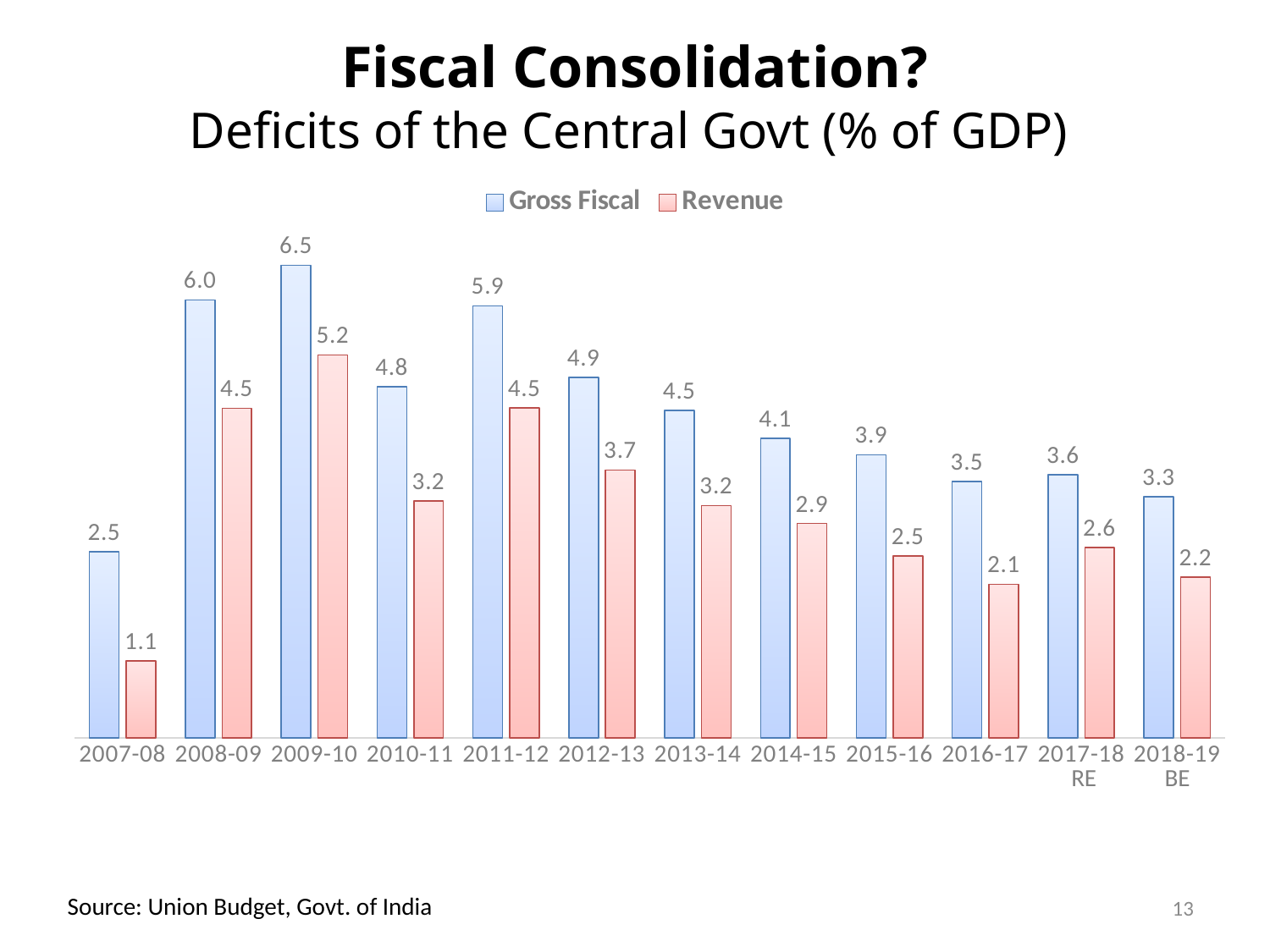
How many series does the legend list? 2 What is the Revenue deficit for 2018-19 BE? 2.2 Which is larger, the Revenue deficit in 2011-12 or in 2012-13? 2011-12 How many years are shown on the x axis? 12 What is the Gross Fiscal deficit for 2009-10? 6.5 What is the Revenue deficit for 2007-08? 1.1 What is the difference between the Gross Fiscal and Revenue deficits in 2010-11? 1.6 Does the Gross Fiscal deficit rise or fall from 2011-12 to 2018-19 BE? Fall What kind of chart is shown on the slide? Bar chart Which year has the lowest Revenue deficit? 2007-08 Which colour represents the Revenue series in the chart? Red (pink) Which year has the highest Gross Fiscal deficit? 2009-10